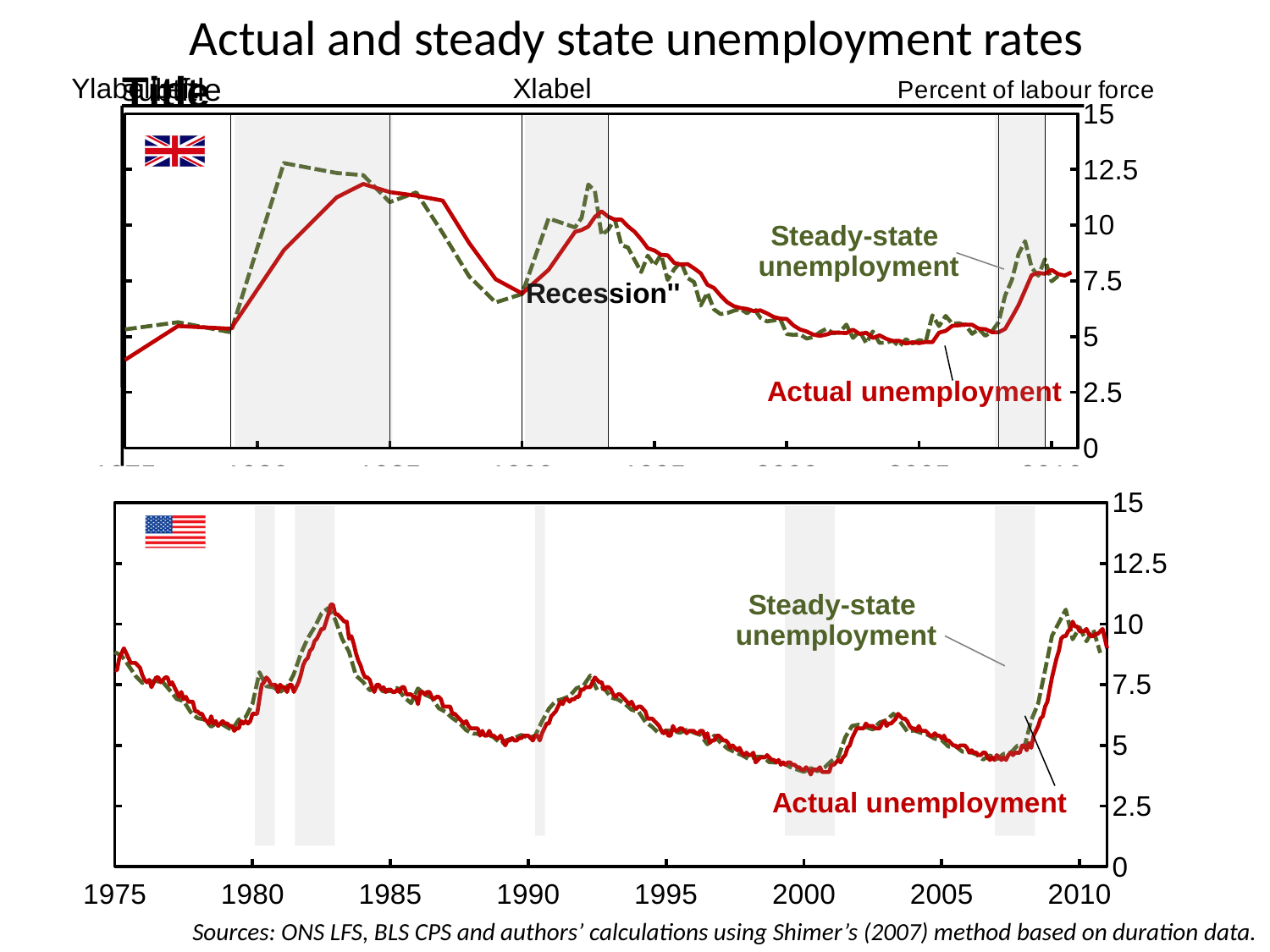
What unit label is shown above the y axis of the top chart? Percent of labour force How many series are plotted in the bottom (US) chart? 2 In the bottom (US) chart, is the peak of actual unemployment around 1983 greater or less than 10? greater In the bottom (US) chart, does actual unemployment rise or fall between 2007 and 2009? rise What is the title of the slide's charts? Actual and steady state unemployment rates In the bottom (US) chart, does actual unemployment rise or fall between 1983 and 1989? fall In the bottom (US) chart, is the value of actual unemployment around 2000 greater or less than 5? less What kind of chart is the top (UK) chart? line chart In the bottom (US) chart, is the value of actual unemployment in 1975 greater or less than 7.5? greater In the top (UK) chart, around 1981, which series is higher: steady-state unemployment or actual unemployment? Steady-state unemployment